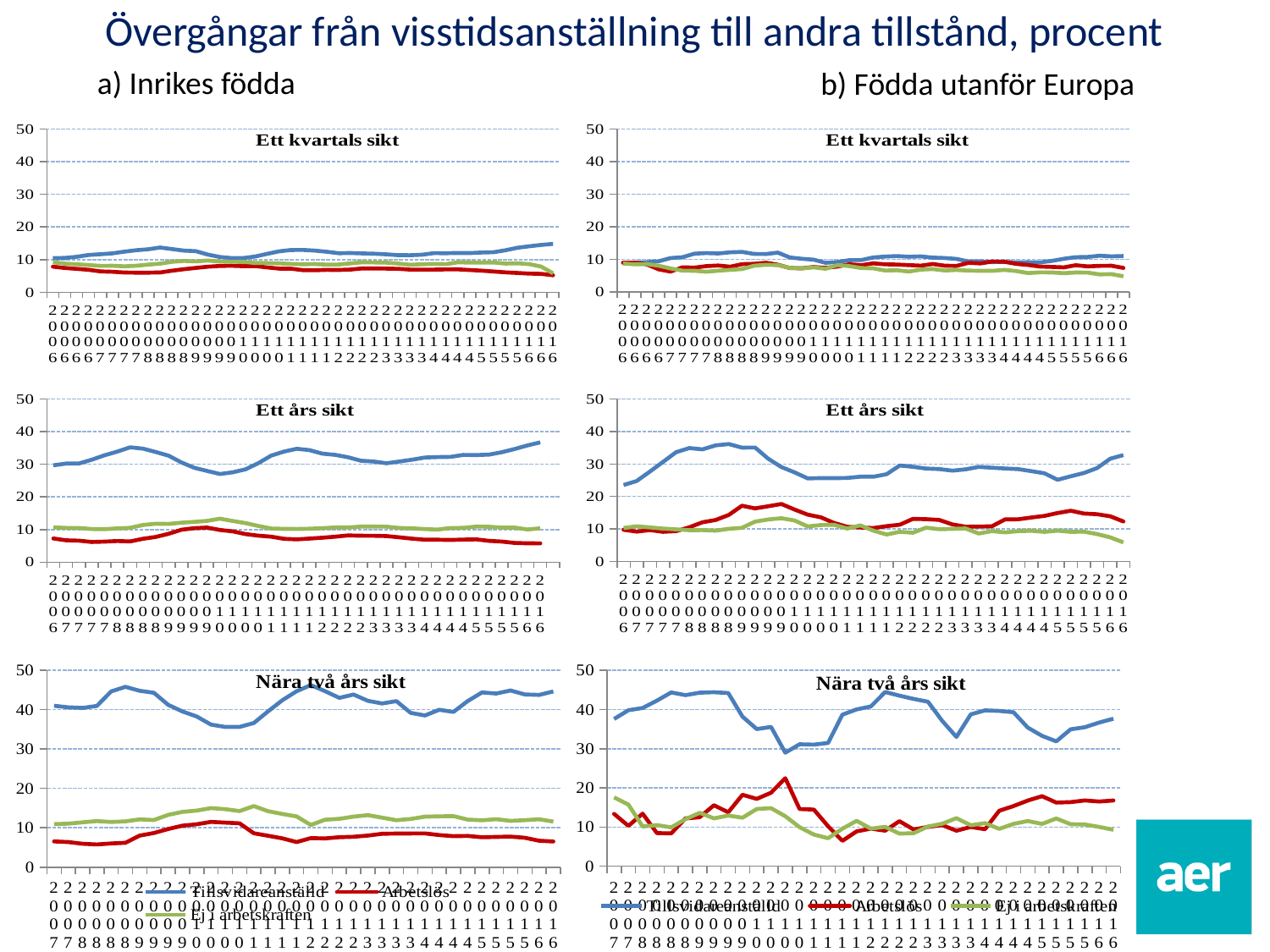
In the 'Nära två års sikt' chart for Födda utanför Europa, which series has the lowest value at the end of the period? Ej i arbetskraften In the 'Ett års sikt' chart for Födda utanför Europa, is the peak value for Arbetslös greater or less than 10? greater In the 'Nära två års sikt' chart for Inrikes födda, is the value for Arbetslös greater or less than 20 throughout the period? less In the 'Ett års sikt' chart for Inrikes födda, which is larger at the end of the period, Ej i arbetskraften or Arbetslös? Ej i arbetskraften Which colour represents Arbetslös in the charts? red What is the title of the slide? Övergångar från visstidsanställning till andra tillstånd, procent How many series does the legend list for the charts? 3 In the 'Ett års sikt' chart for Inrikes födda, is the value for Tillsvidareanställd greater or less than 20 throughout the period? greater In the 'Ett kvartals sikt' chart for Inrikes födda, which series has the highest values throughout the period? Tillsvidareanställd What kind of chart is used in the panels on this slide? line chart In the 'Nära två års sikt' chart for Födda utanför Europa, does the Arbetslös series rise or fall from 2013 to 2016? rise How many charts are shown on the slide? 6